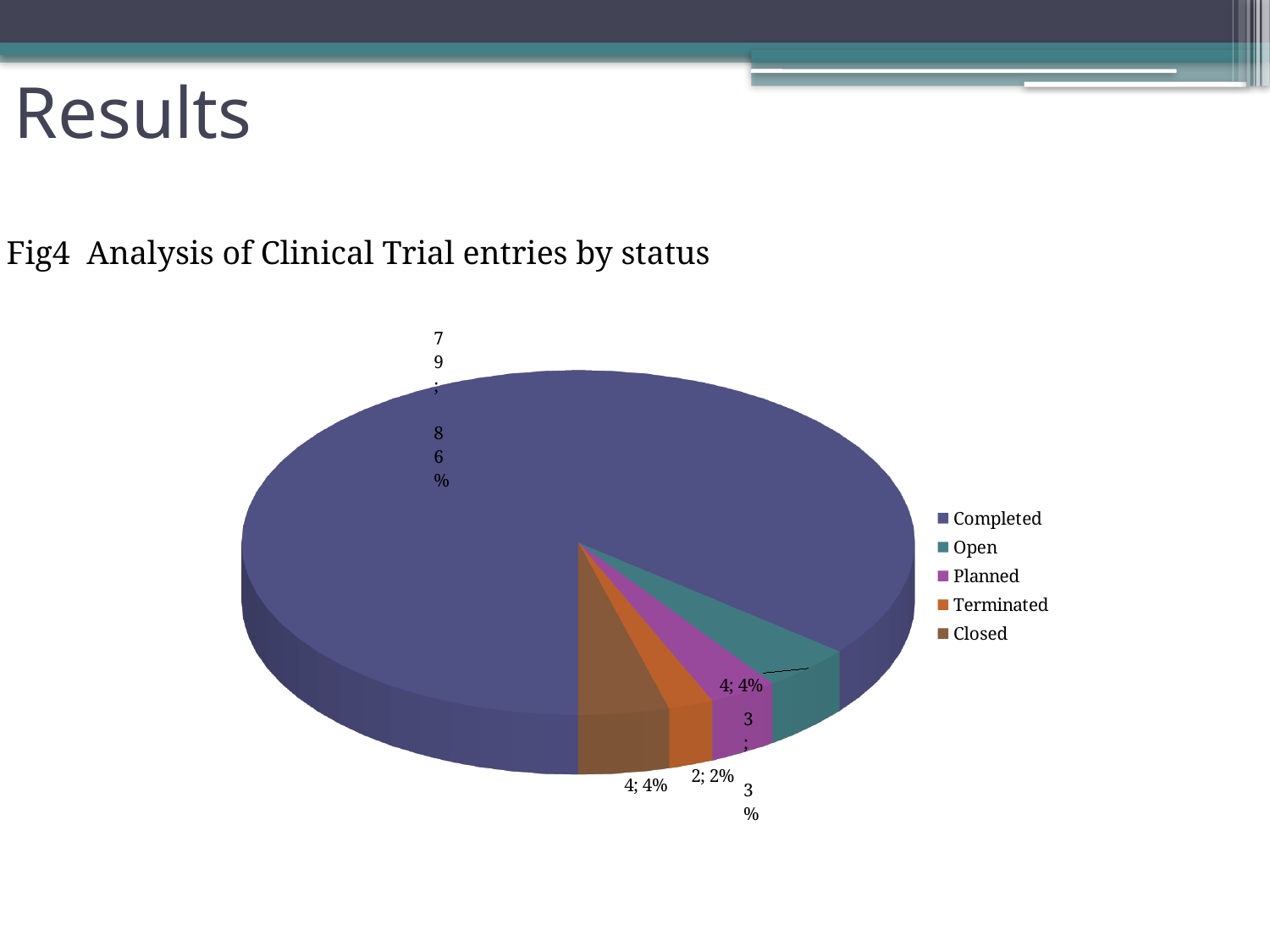
What is the title of the chart on the slide? Fig4 Analysis of Clinical Trial entries by status What is the count of Terminated entries shown on the pie chart? 2 Which status category has the smallest slice of the pie? Terminated How many categories does the legend of the pie chart list? 5 What percentage share of the pie does the Completed slice have? 86% Which legend entry is shown in orange on the pie chart? Terminated Which has more entries, Planned or Terminated? Planned Which status category has the largest slice of the pie? Completed What is the count of Completed clinical trial entries shown on the pie chart? 79 What kind of chart is shown on the slide? pie chart What is the difference between the number of Completed entries and the number of Planned entries? 76 What percentage share of the pie does the Planned slice have? 3%